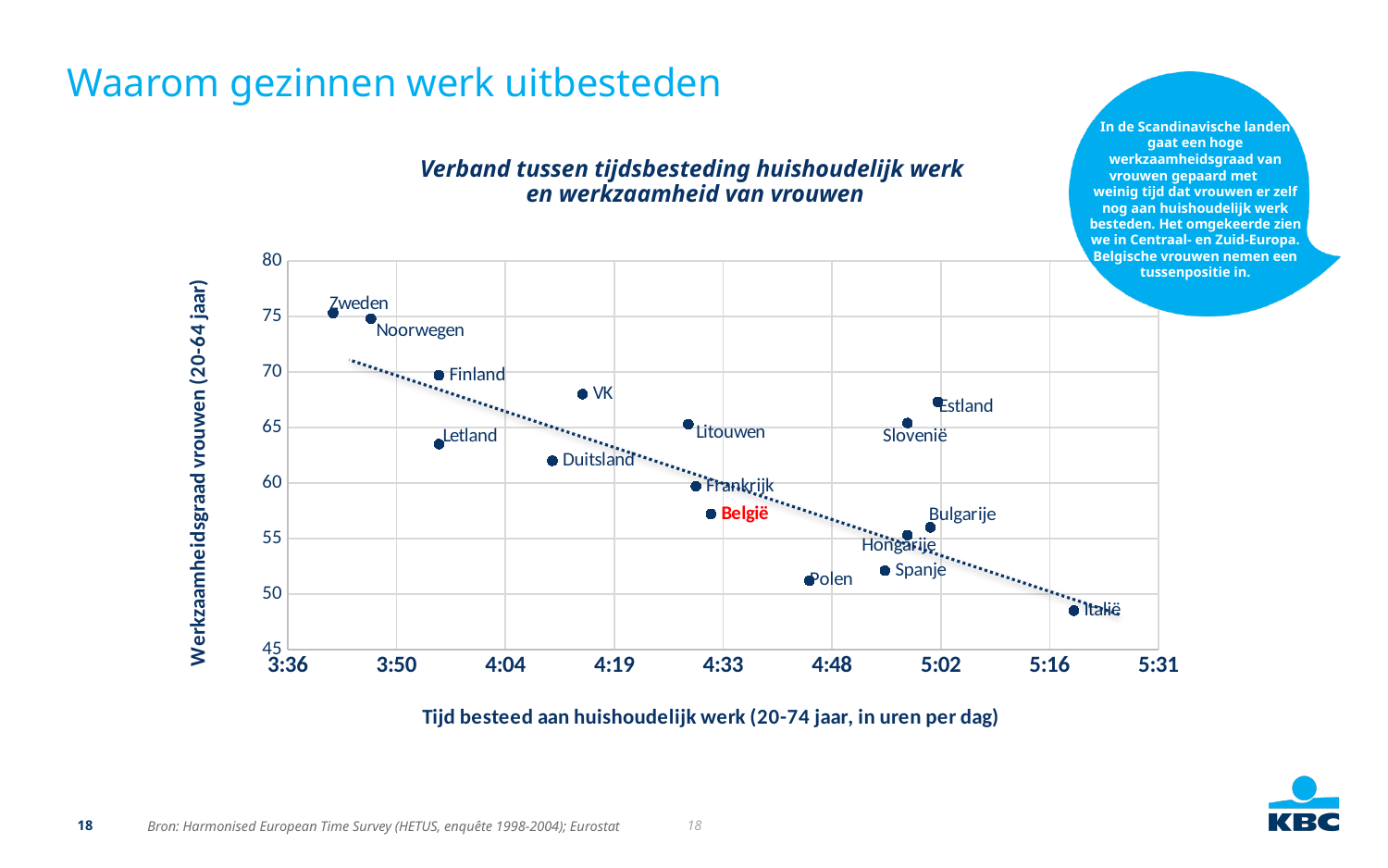
Is the female employment rate for Finland greater or less than 65? greater As time spent on household work increases along the x axis, does the female employment rate generally rise or fall? Fall How many countries are plotted in the chart? 16 Which has a higher female employment rate, Estland or Bulgarije? Estland Which country spends the least time on household work (furthest left on the x axis)? Zweden Is the female employment rate for België greater or less than 60? less What is the title of the chart? Verband tussen tijdsbesteding huishoudelijk werk en werkzaamheid van vrouwen Which country spends the most time on household work (furthest right on the x axis)? Italië Which country has the lowest female employment rate in the chart? Italië What kind of chart is shown on the slide? Scatter chart Is the female employment rate for Polen greater or less than 55? less Which country has the highest female employment rate (Werkzaamheidsgraad vrouwen) in the chart? Zweden